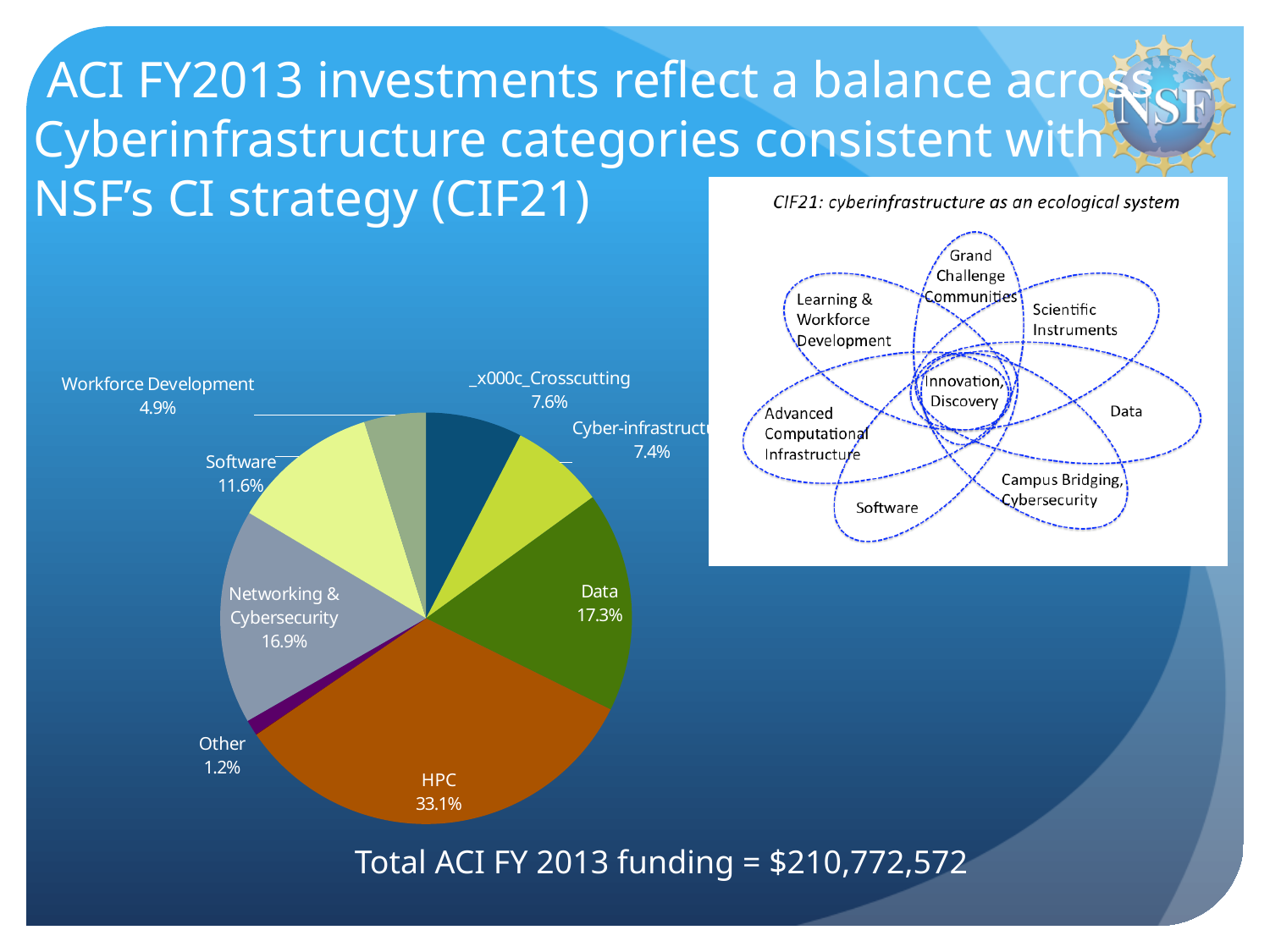
Which is larger, the share for Data or the share for Networking & Cybersecurity? Data How many slices does the pie chart have? 8 Which category has the smallest slice of the pie? Other What percentage is shown for Data in the pie chart? 17.3% What percentage is shown for Networking & Cybersecurity? 16.9% What percentage is shown for Crosscutting? 7.6% Which category has the largest slice of the pie? HPC What kind of chart is shown on the slide? pie chart What is the total ACI FY 2013 funding stated below the pie chart? $210,772,572 What share of the pie does HPC account for? 33.1% What percentage is shown for Workforce Development? 4.9% What percentage is shown for Software? 11.6%